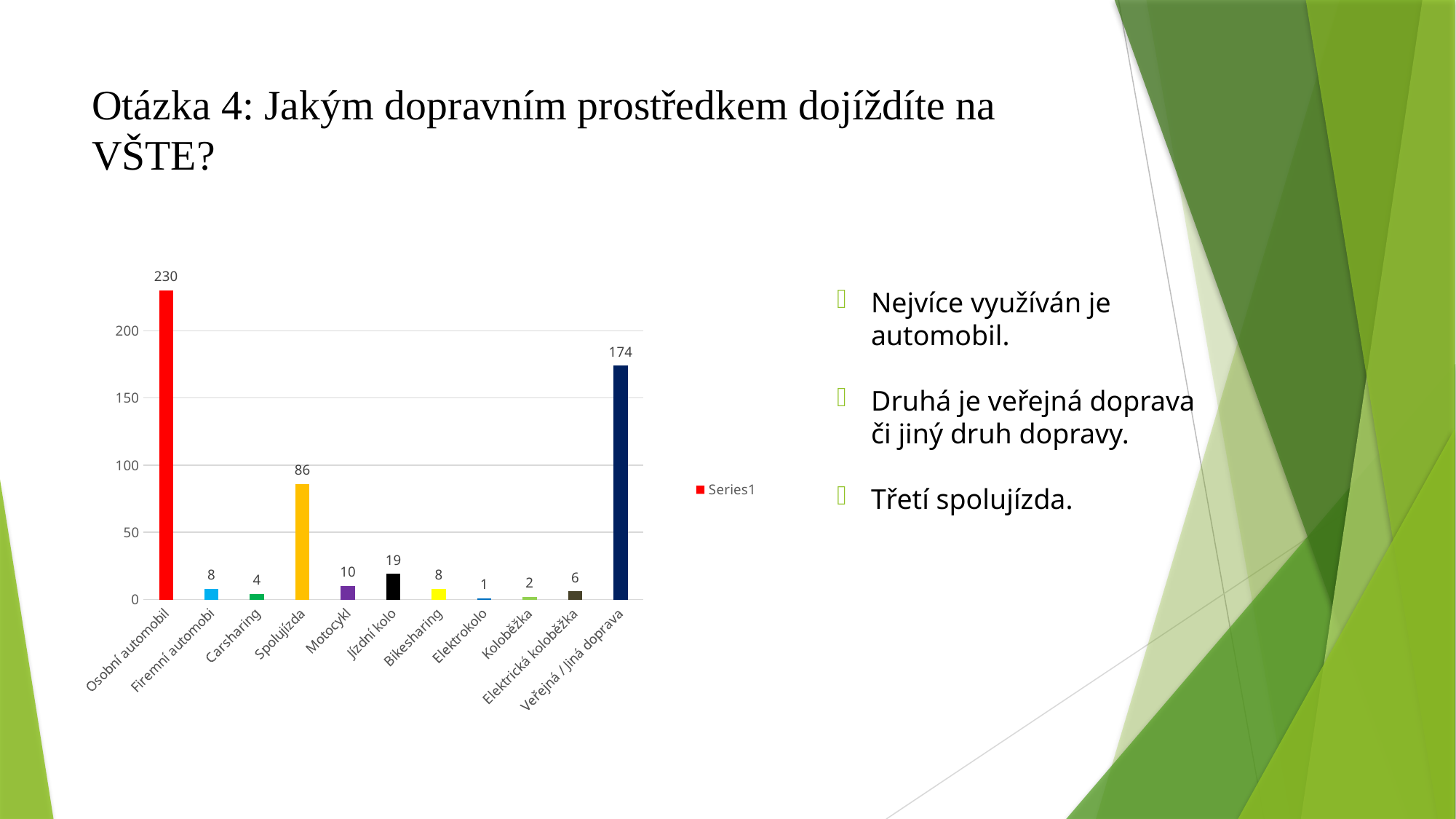
What is the value for Jízdní kolo? 19 What is the value for Osobní automobil? 230 How many categories are shown on the x axis? 11 What is the value for Spolujízda? 86 What is the difference between the values for Osobní automobil and Veřejná / Jiná doprava? 56 Which category has the highest value? Osobní automobil What kind of chart is shown on the slide? bar chart Which category has the lowest value? Elektrokolo What is the name of the series listed in the legend? Series1 Which is larger, the value for Motocykl or the value for Jízdní kolo? Jízdní kolo What is the value for Veřejná / Jiná doprava? 174 Is the value for Spolujízda greater or less than 100? less